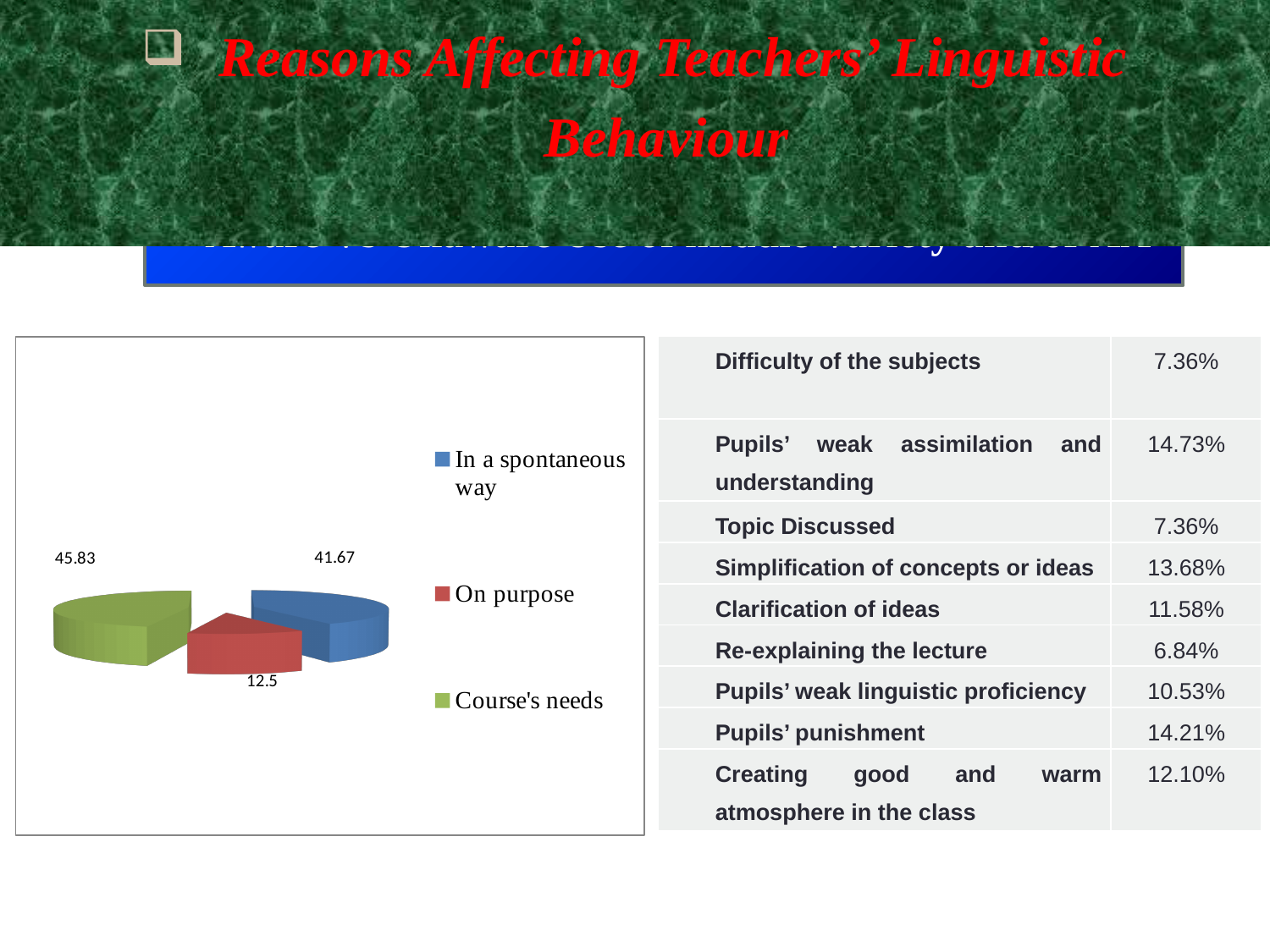
What is the difference between the values for "Course's needs" and "In a spontaneous way" in the pie chart? 4.16 What is the difference between the values for "In a spontaneous way" and "On purpose" in the pie chart? 29.17 Which is larger in the pie chart, "On purpose" or "In a spontaneous way"? In a spontaneous way How many entries does the legend of the pie chart list? 3 What is the value for "Course's needs" in the pie chart? 45.83 What colour is the "On purpose" slice in the pie chart? Red How many slices does the pie chart have? 3 Which category has the largest slice in the pie chart? Course's needs Which category has the smallest slice in the pie chart? On purpose What is the value for "On purpose" in the pie chart? 12.5 What is the value for "In a spontaneous way" in the pie chart? 41.67 What kind of chart is shown on the slide? Pie chart